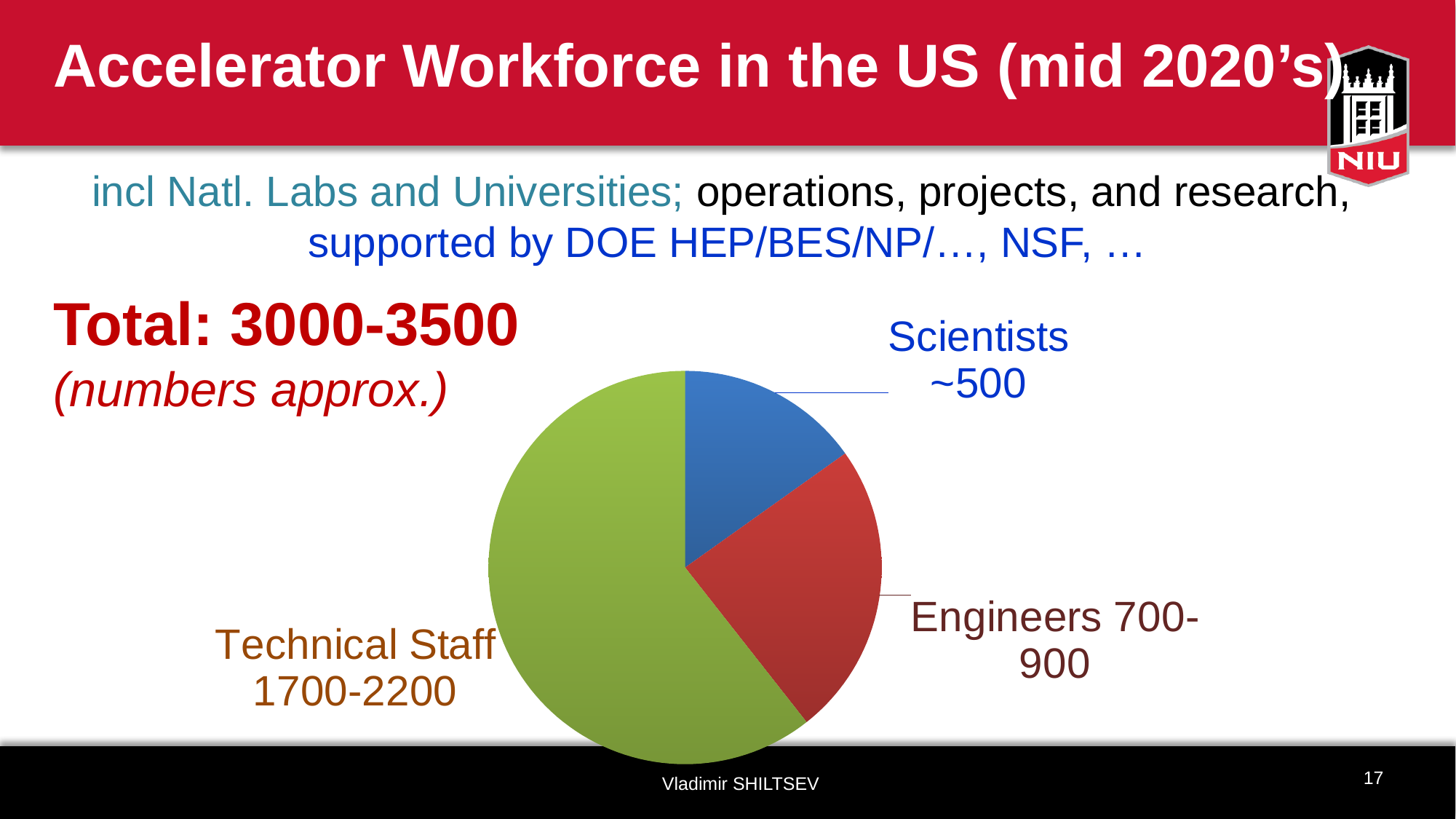
What kind of chart is shown on the slide? pie chart What is the title of the slide containing the pie chart? Accelerator Workforce in the US (mid 2020's) Which category has the largest slice of the pie chart? Technical Staff Which slice is larger, Engineers or Scientists? Engineers What number is labelled for Scientists on the pie chart? ~500 What colour is the Technical Staff slice of the pie chart? green Which category has the smallest slice of the pie chart? Scientists Which slice is larger, Technical Staff or Engineers? Technical Staff What total workforce is stated on the slide? 3000-3500 What range is labelled for Engineers on the pie chart? 700-900 What range is labelled for Technical Staff on the pie chart? 1700-2200 How many slices does the pie chart have? 3